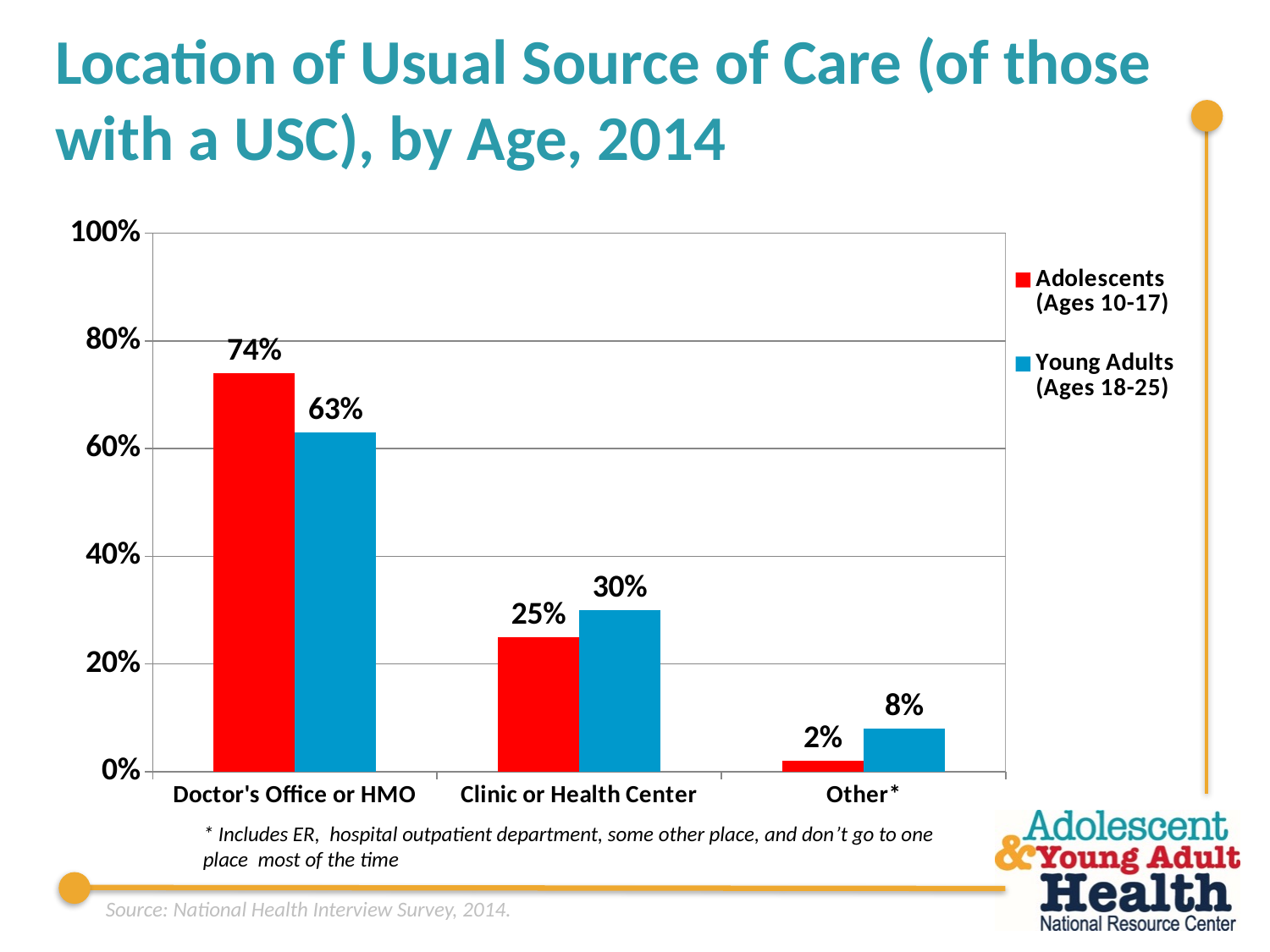
How many location categories are shown on the x axis? 3 What percentage of Adolescents (Ages 10-17) have a Doctor's Office or HMO as their usual source of care? 74% How many series does the legend list? 2 Which location category has the lowest value for Young Adults (Ages 18-25)? Other* Which location category has the highest value for Adolescents (Ages 10-17)? Doctor's Office or HMO Which group has the larger value for Clinic or Health Center, Adolescents (Ages 10-17) or Young Adults (Ages 18-25)? Young Adults (Ages 18-25) What colour represents Young Adults (Ages 18-25) in the chart? Blue What kind of chart is shown on the slide? Bar chart Do the values for Adolescents (Ages 10-17) rise or fall from left to right across the categories? Fall What is the value for Young Adults (Ages 18-25) in the Other* category? 8% What percentage of Young Adults (Ages 18-25) have a Clinic or Health Center as their usual source of care? 30% What is the difference between Adolescents and Young Adults for Doctor's Office or HMO? 11 percentage points